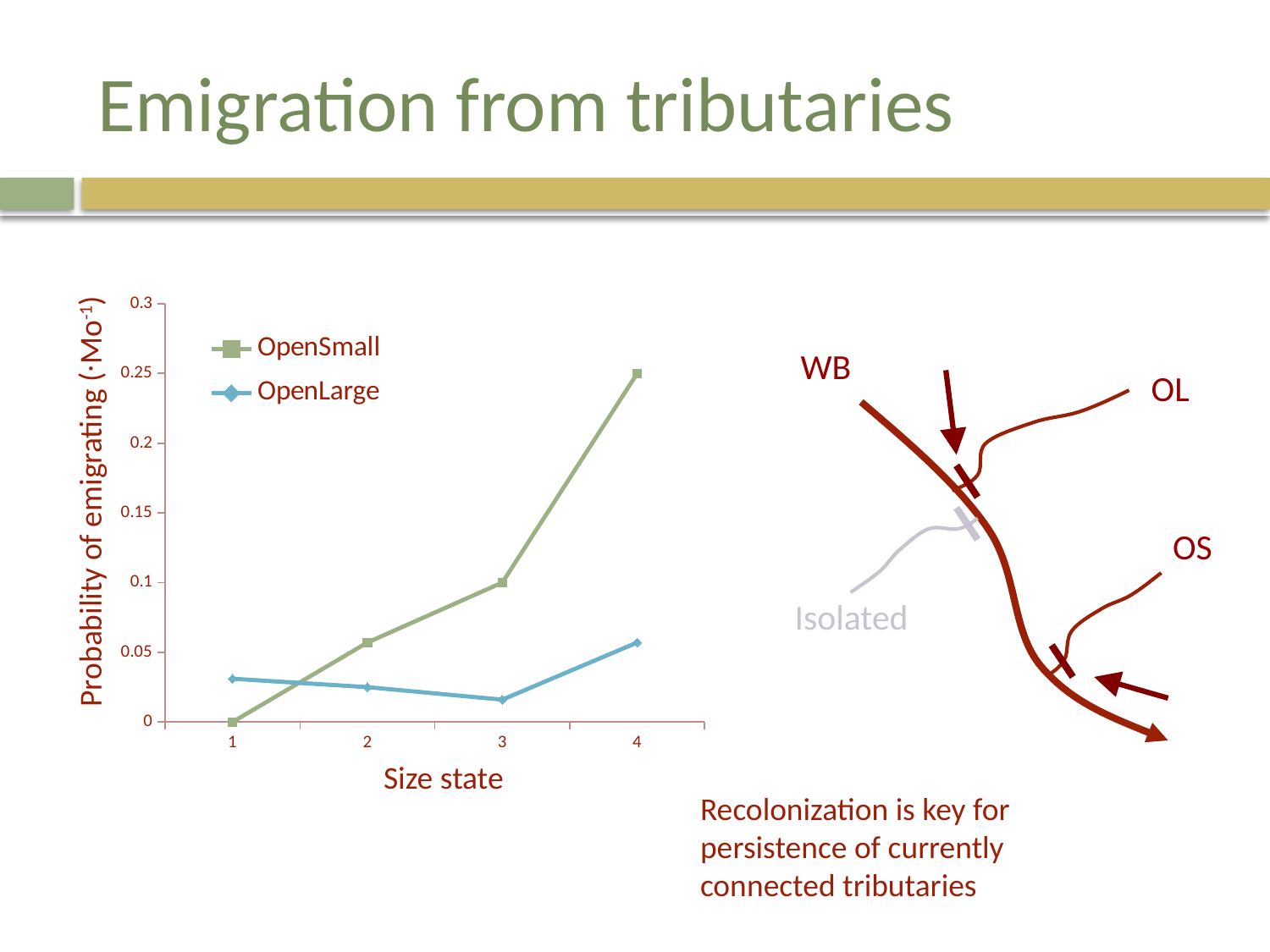
What is the probability of emigrating for OpenSmall at size state 1? 0 How many size states are plotted along the x axis? 4 What is the probability of emigrating for OpenSmall at size state 3? 0.1 What is the probability of emigrating for OpenSmall at size state 4? 0.25 Is the OpenLarge value at size state 4 greater or less than 0.1? less What kind of chart is shown on the slide? line chart What is the difference between the OpenSmall values at size state 4 and size state 3? 0.15 Does the OpenSmall series rise or fall as size state increases from 1 to 4? rise At size state 1, which series has the higher probability of emigrating, OpenSmall or OpenLarge? OpenLarge At which size state is the OpenSmall probability of emigrating highest? 4 At size state 4, which series has the higher probability of emigrating, OpenSmall or OpenLarge? OpenSmall How many series does the chart legend list? 2